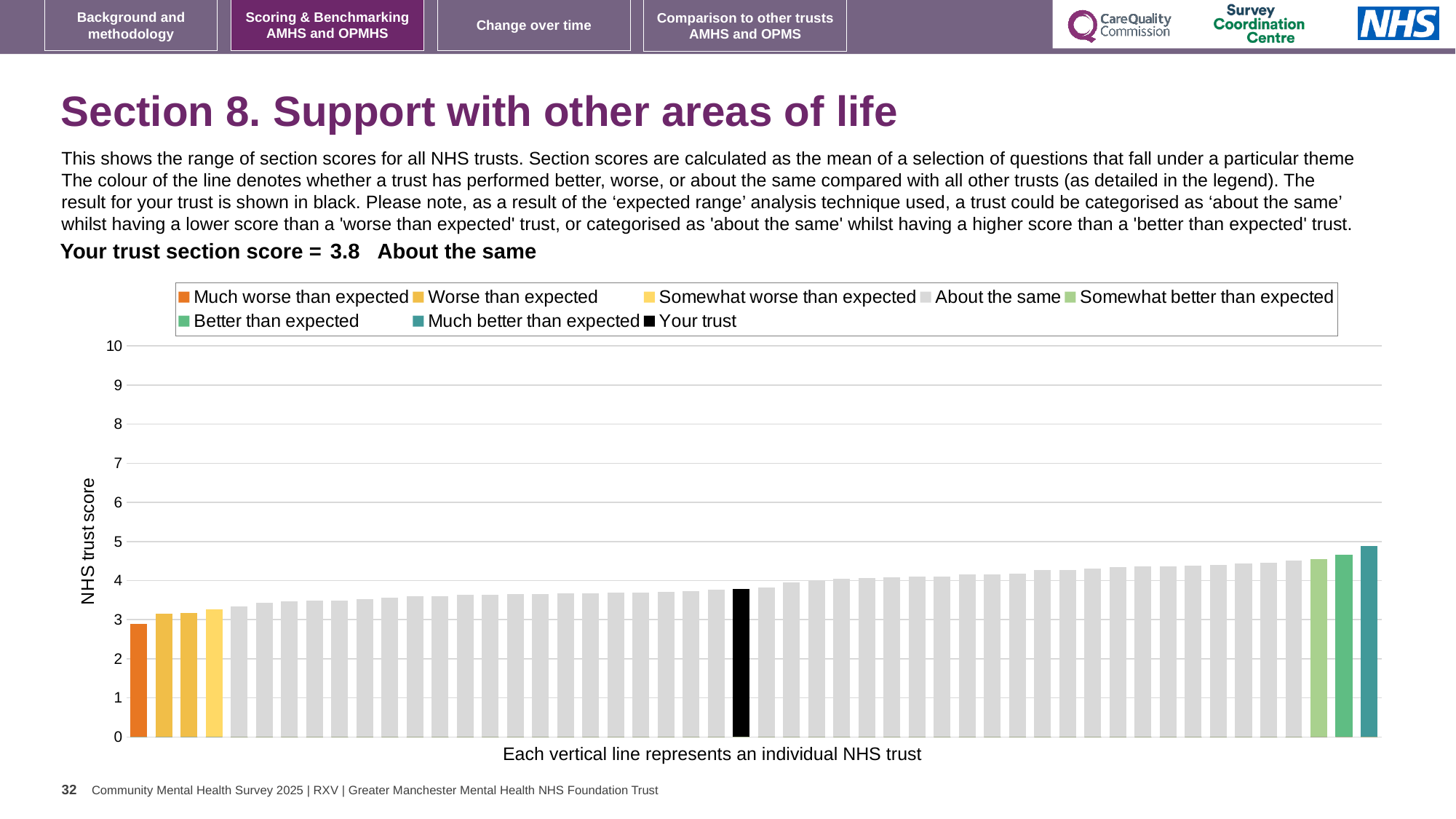
Which is larger, the black 'Your trust' bar or the orange 'Much worse than expected' bar? Your trust What kind of chart is shown on the slide? bar chart Which legend category does the shortest bar in the chart belong to? Much worse than expected Which legend category does the tallest bar in the chart belong to? Much better than expected Is the value of the black 'Your trust' bar greater or less than 3? greater Is the value of the shortest bar in the chart greater or less than 4? less What is the label on the vertical axis of the chart? NHS trust score What is the section score for your trust shown on the slide? 3.8 Is the value of the black 'Your trust' bar greater or less than 4? less How many entries does the chart legend list? 8 Do the bar values rise or fall from left to right along the x axis? rise